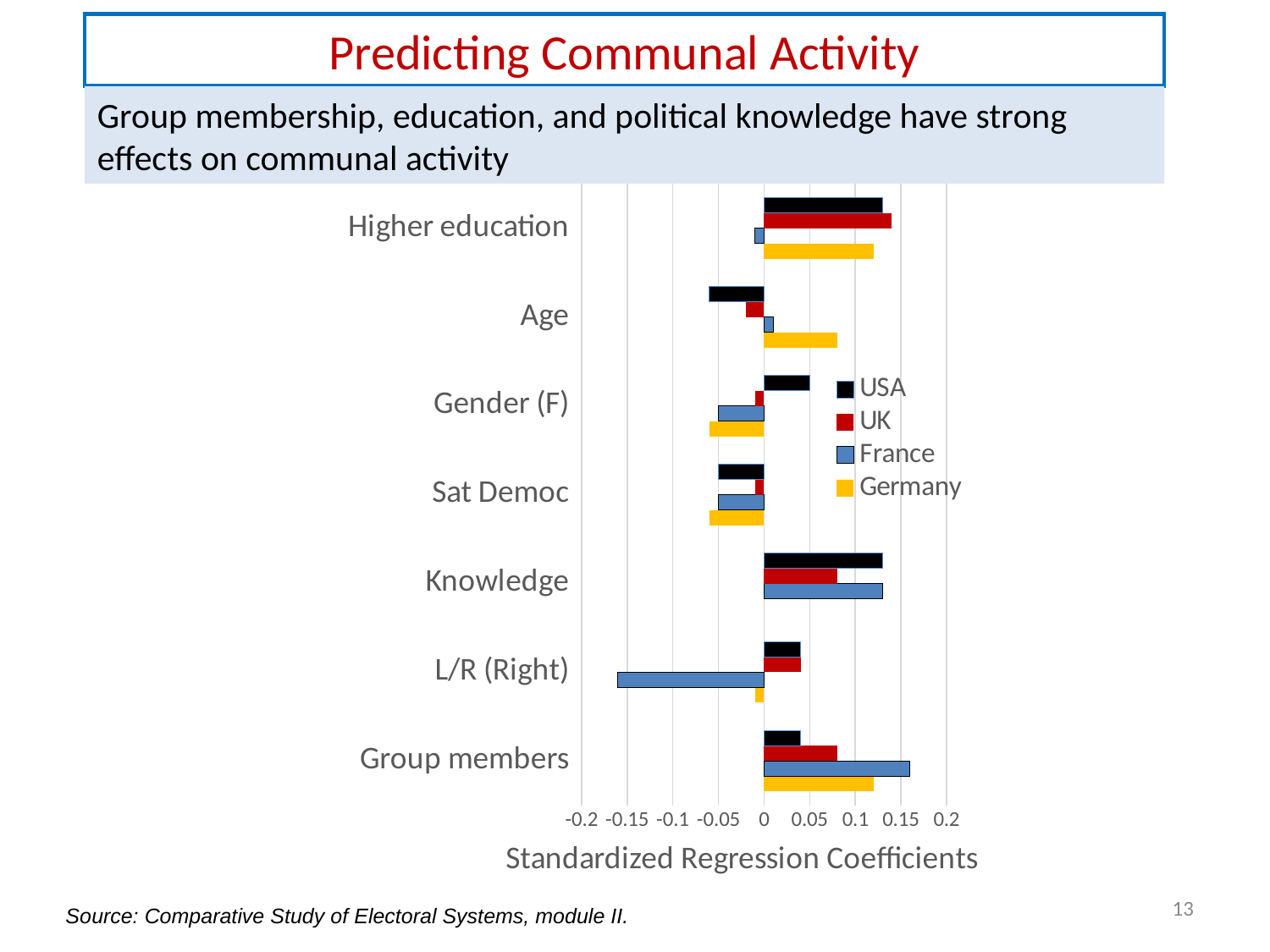
How many categories are plotted on the y axis of the chart? 7 Is the value for France in the Group members category greater or less than 0.1? greater For Group members, which is larger: the value for France or the value for USA? France Is the value for France in the L/R (Right) category greater or less than -0.1? less Is the value for UK in the Higher education category greater or less than 0.1? greater What kind of chart is shown on the slide? bar chart How many series does the chart's legend list? 4 For Knowledge, which is larger: the value for USA or the value for UK? USA What is the title of the chart's x axis? Standardized Regression Coefficients Which category has the lowest value for France? L/R (Right) Which country is shown in black in the chart's legend? USA